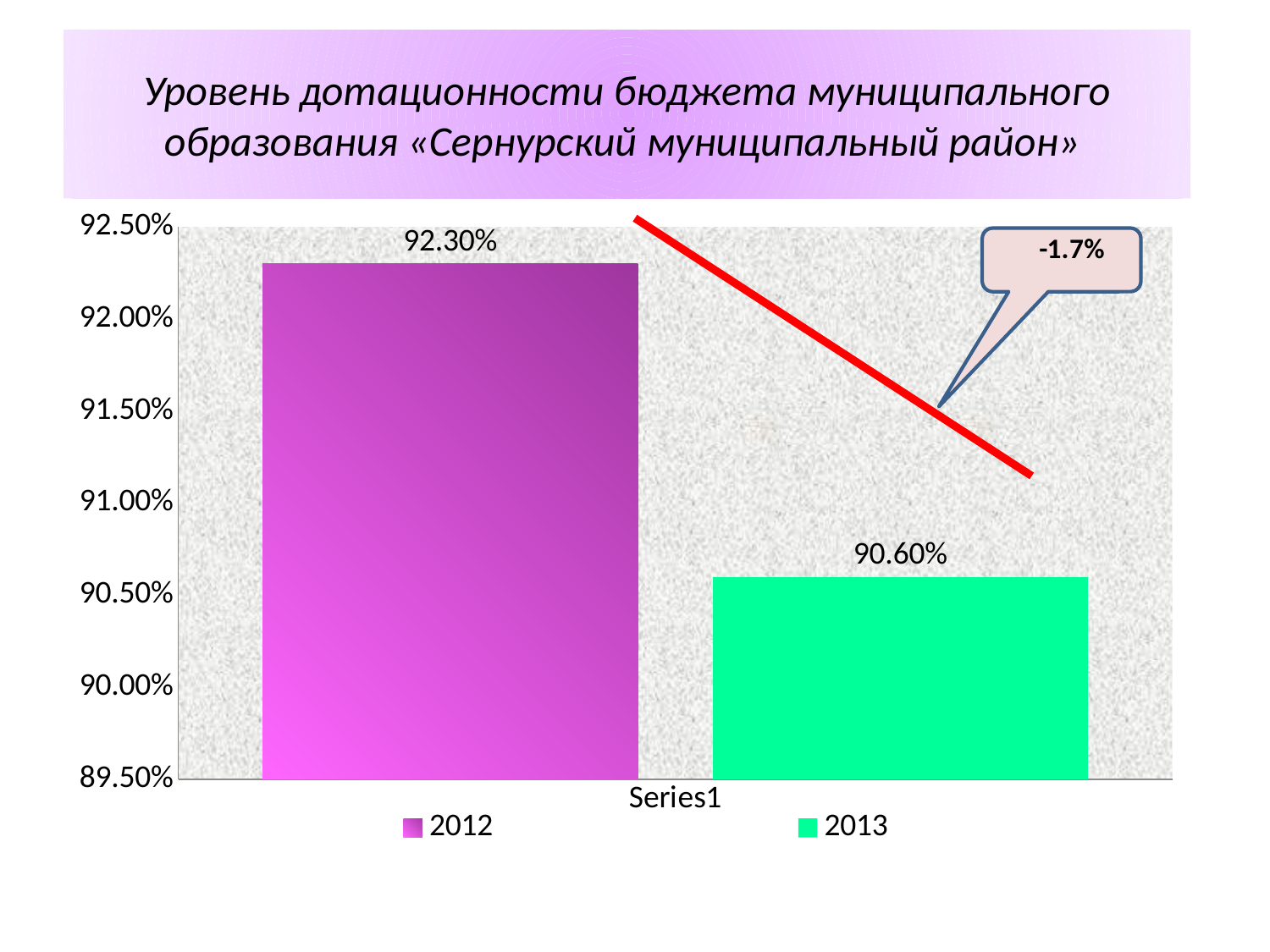
What is the lowest value shown on the vertical axis? 89.50% Is the value for 2012 greater or less than 92.00%? greater What is the value for 2012? 92.30% What colour is the bar for 2013? green Which series has the lowest value? 2013 What kind of chart is shown on the slide? bar chart Is the value for 2013 greater or less than 91.00%? less Which year has the higher value, 2012 or 2013? 2012 What is the value for 2013? 90.60% How many series does the legend list? 2 What change is shown in the callout on the chart? -1.7% What is the difference between the 2012 and 2013 values? 1.70%